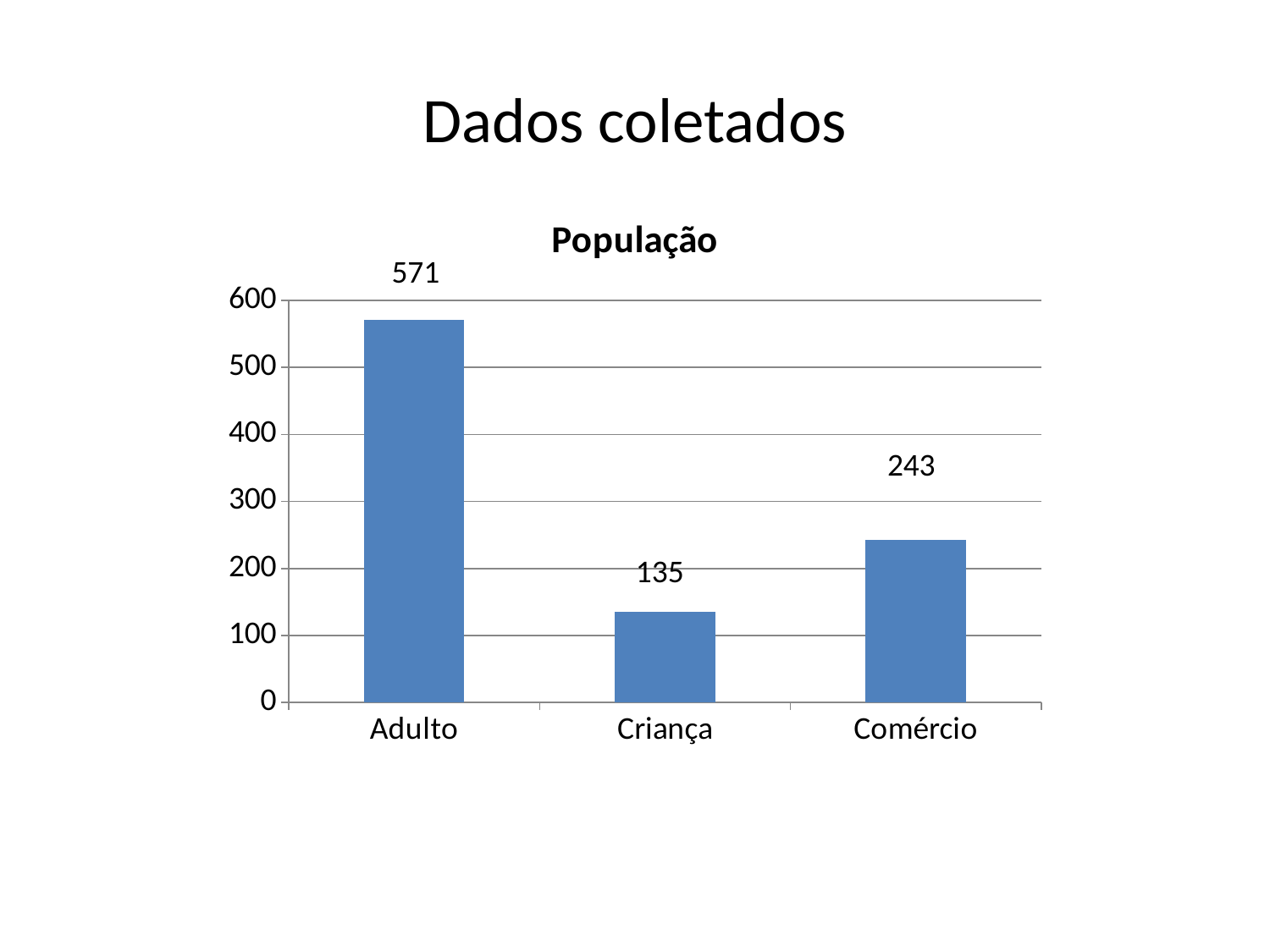
What is the difference between the values for Adulto and Comércio? 328 Which is larger, the value for Criança or the value for Comércio? Comércio What kind of chart is shown on the slide? bar chart What is the value for Adulto? 571 Which category has the lowest value? Criança What is the value for Comércio? 243 How many categories are shown on the x axis? 3 What is the title of the chart? População Is the value for Comércio greater or less than 200? greater What is the value for Criança? 135 Which category has the highest value? Adulto What is the difference between the values for Comércio and Criança? 108